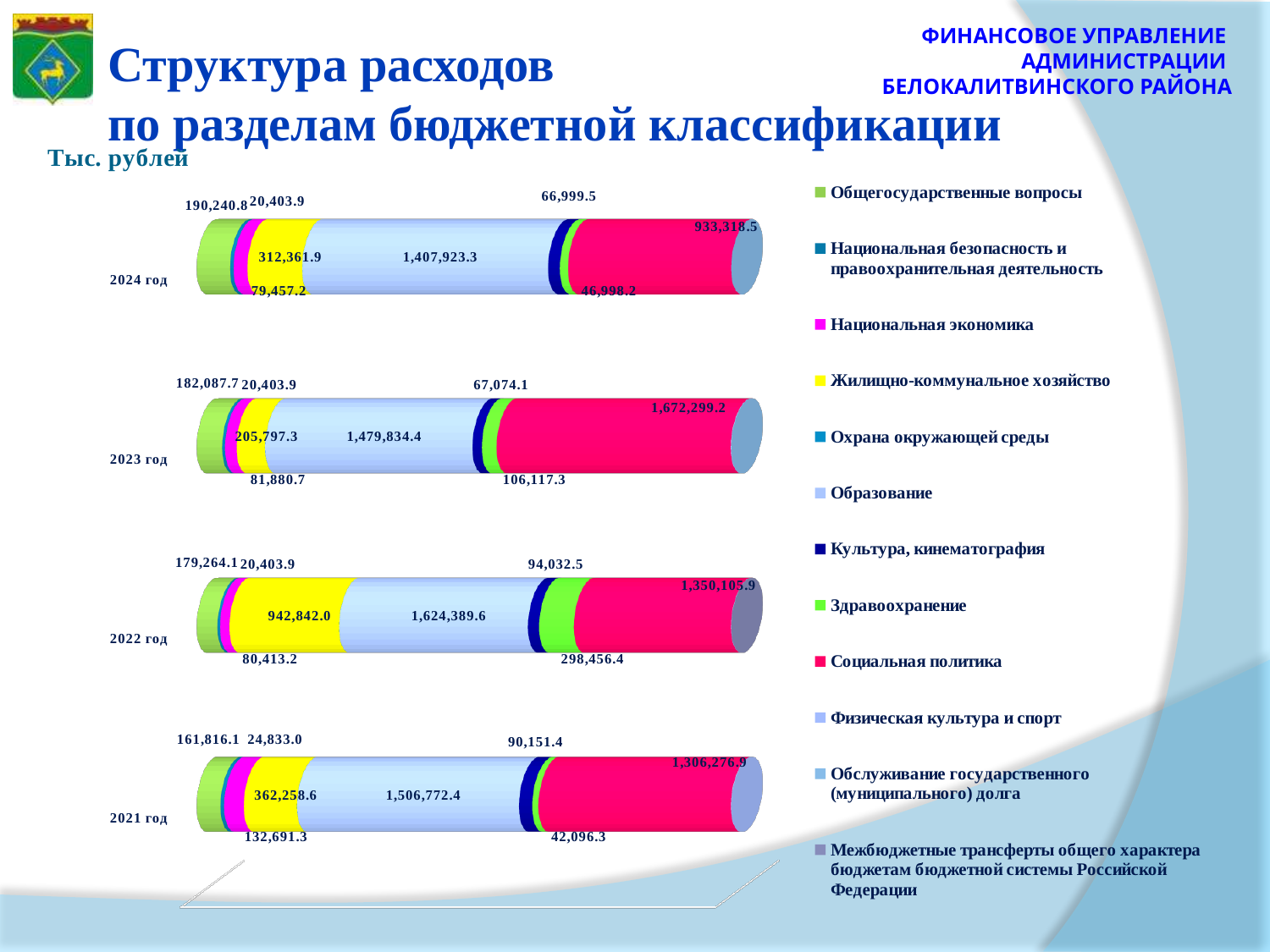
What is the value for Образование in 2024? 1,407,923.3 How many years (bars) does the chart show? 4 In which year is the value for Образование the highest? 2022 год What is the value for Жилищно-коммунальное хозяйство in 2021? 362,258.6 How many series does the legend list? 12 What is the value for Социальная политика in 2023? 1,672,299.2 Which is larger: Социальная политика in 2023 or in 2024? 2023 In what units are the values on the chart given? Тыс. рублей In which year is the value for Социальная политика the lowest? 2024 год What is the difference between the Образование values for 2023 and 2024? 71,911.1 What is the value for Образование in 2022? 1,624,389.6 What kind of chart is shown on the slide? Stacked bar chart